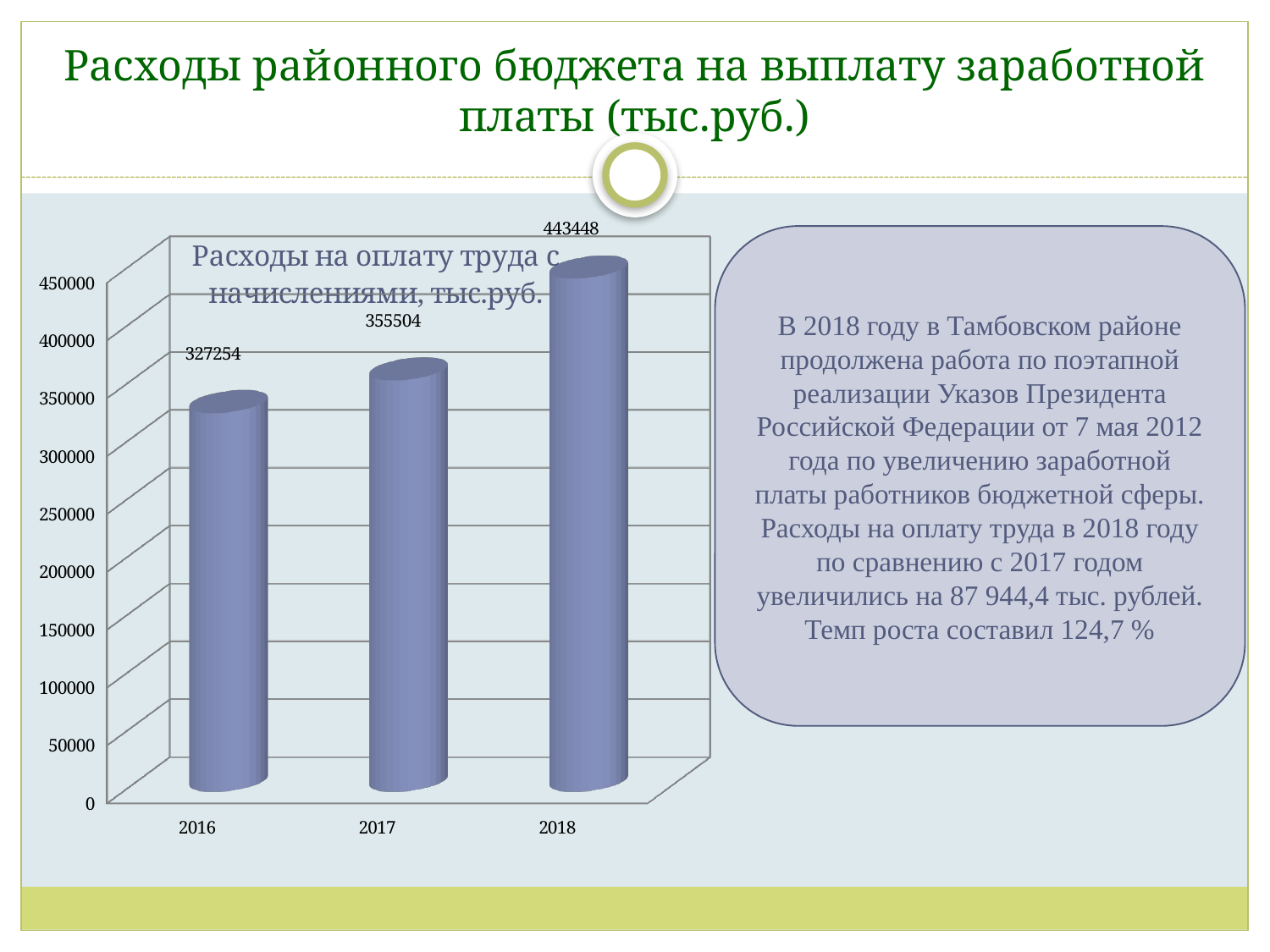
What is the difference between the values for 2017 and 2016? 28250 Is the value for 2018 greater or less than 400000? greater What is the value for 2018? 443448 What is the difference between the values for 2018 and 2017? 87944 How many years are shown on the chart? 3 Do the values rise or fall from 2016 to 2018? rise Which is larger, the value for 2017 or the value for 2016? 2017 What is the value for 2016? 327254 Which year has the highest value? 2018 What kind of chart is shown on the slide? bar chart Which year has the lowest value? 2016 What is the value for 2017? 355504